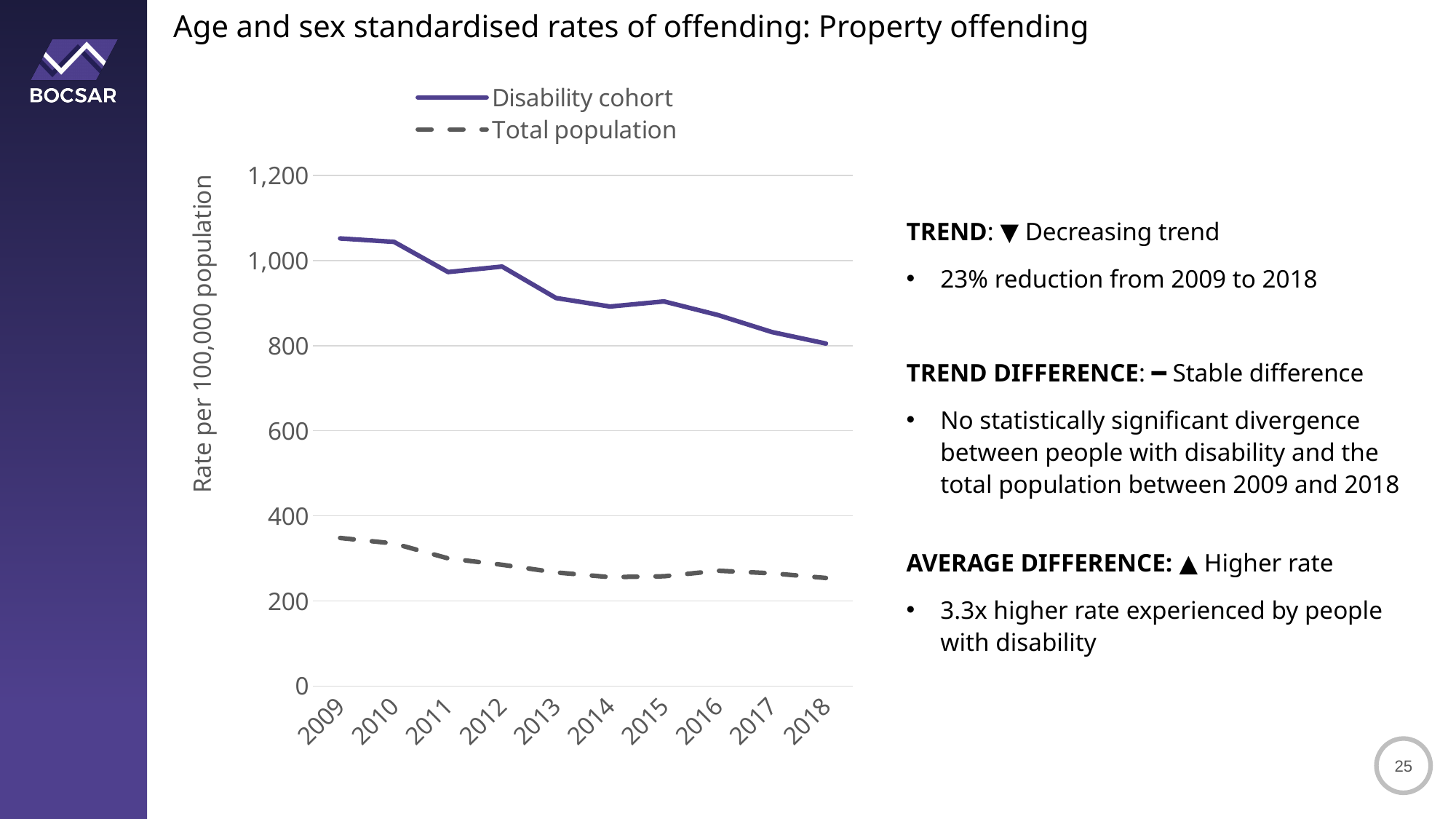
In which year is the Total population rate highest? 2009 Which series is drawn with a dashed line? Total population Does the Disability cohort rate generally rise or fall from 2009 to 2018? Fall Is the Disability cohort rate in 2009 greater or less than 1,000? greater What kind of chart is shown on the slide? Line chart In which year is the Disability cohort rate lowest? 2018 Is the Total population rate in 2014 greater or less than 400? less Is the Disability cohort rate in 2018 greater or less than 1,000? less How many years are plotted along the x axis? 10 Which series has the higher rate in 2015, Disability cohort or Total population? Disability cohort How many series does the legend list? 2 What is the label on the y axis? Rate per 100,000 population